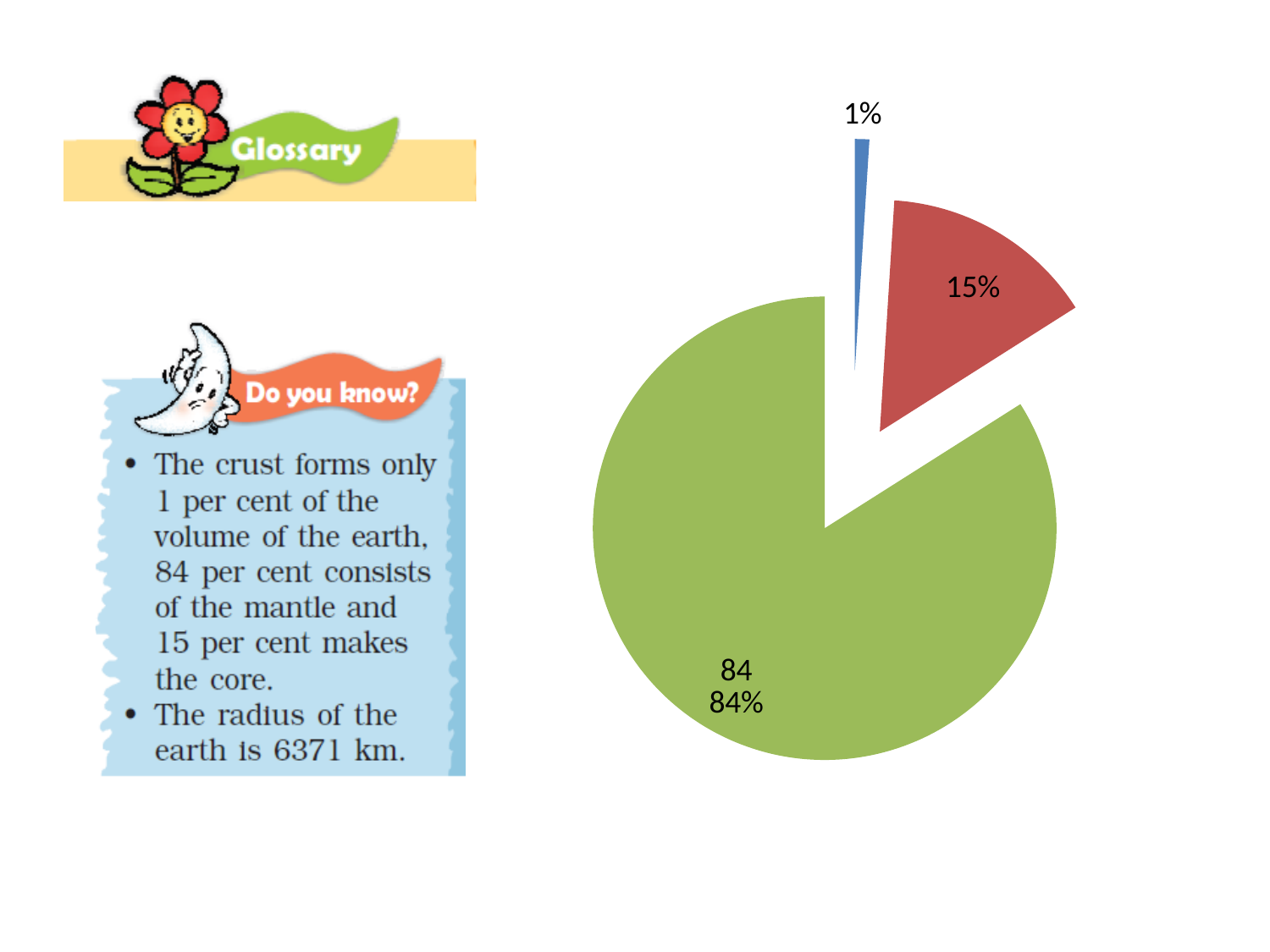
How many slices does the pie chart have? 3 What kind of chart is shown on the right of the slide? pie chart Which is larger in the pie chart, the red slice or the blue slice? red What percentage is shown on the green slice of the pie chart? 84% What percentage is shown on the red slice of the pie chart? 15% What do the three slice percentages in the pie chart add up to? 100% What share of the pie does the red slice represent? 15% Which colour slice is the smallest in the pie chart? blue What is the difference between the green slice and the red slice in the pie chart? 69% Which colour slice is the largest in the pie chart? green What is the difference between the red slice and the blue slice in the pie chart? 14% What percentage is shown on the blue slice of the pie chart? 1%